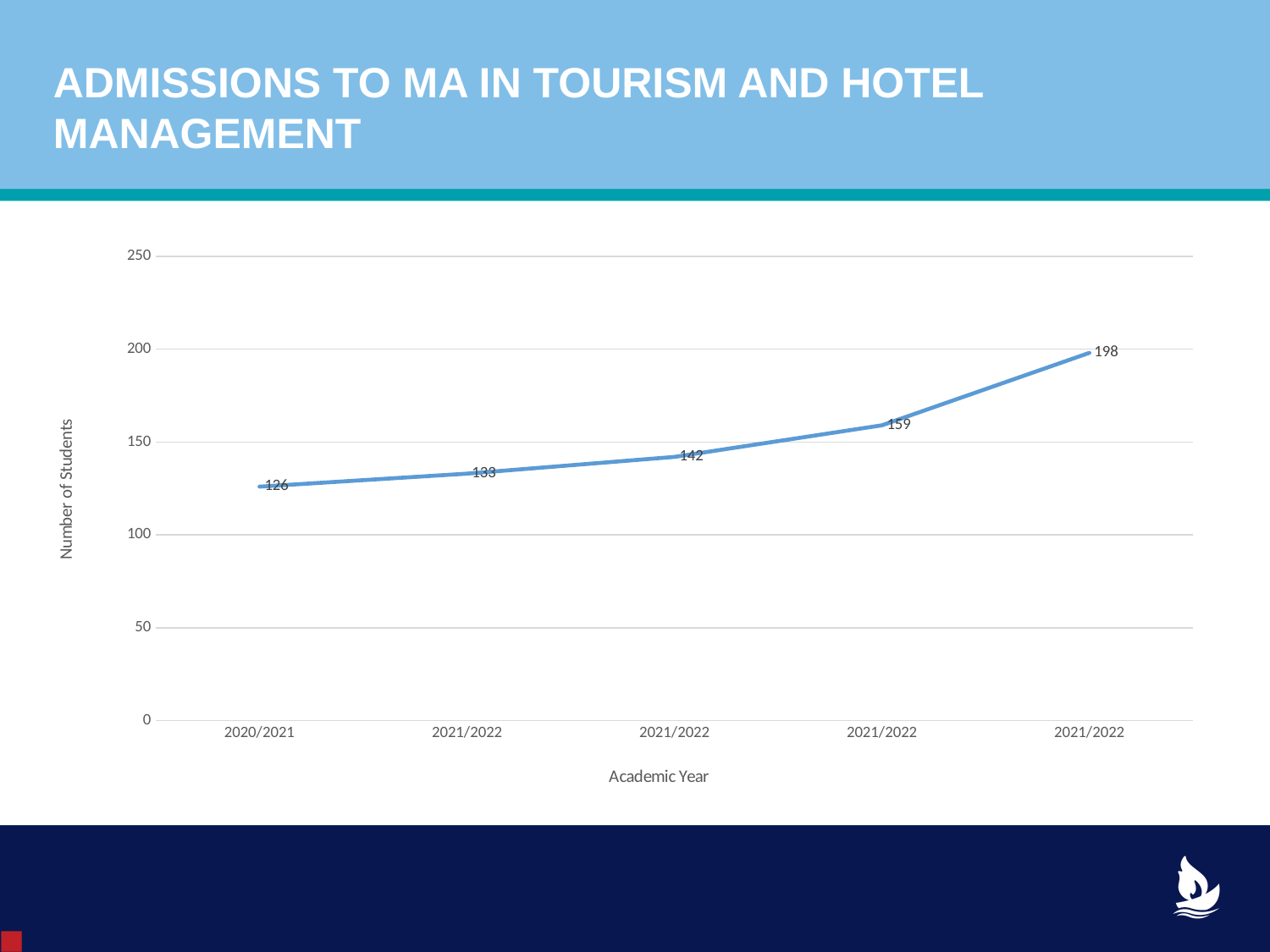
What is the number of students for the 2020/2021 academic year? 126 Do the values rise or fall from left to right along the x axis? rise What is the highest value plotted on the chart? 198 What is the value of the last (rightmost) data point on the line? 198 What is the value of the fourth data point from the left? 159 What is the value of the third data point from the left? 142 What is the label of the vertical axis? Number of Students How many data points are plotted on the line? 5 What type of chart is shown on the slide? line chart Is the value of the second data point from the left greater or less than 150? less What is the lowest value plotted on the chart? 126 What is the difference between the last data point (198) and the first data point (126)? 72